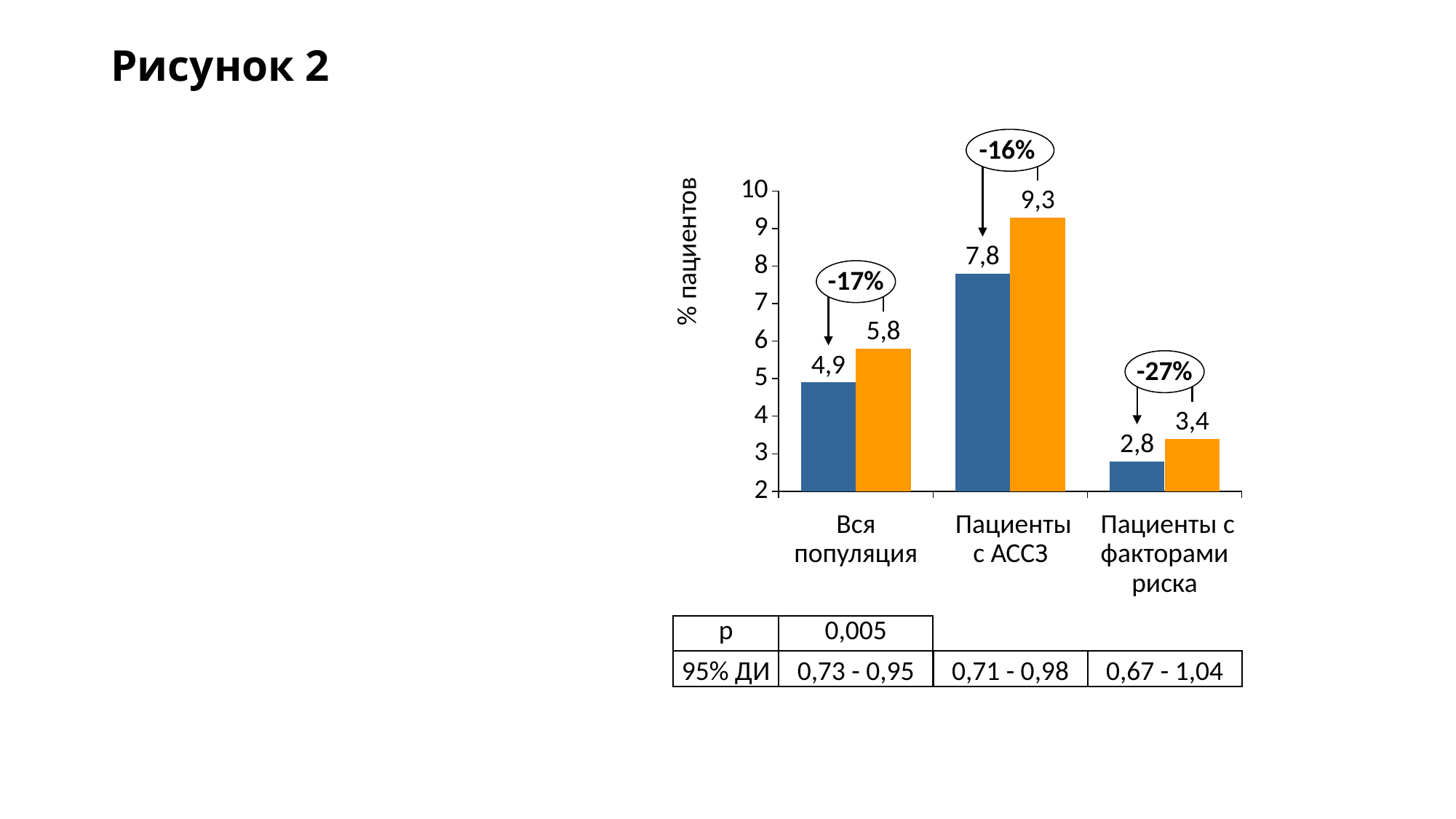
What is the value of the blue bar for Вся популяция? 4,9 What is the difference between the orange and blue bars for Пациенты с АССЗ? 1,5 What is the value of the blue bar for Пациенты с факторами риска? 2,8 What is the label of the vertical axis? % пациентов What is the difference between the orange and blue bars for Вся популяция? 0,9 What kind of chart is shown on the slide? bar chart Which category has the highest orange bar? Пациенты с АССЗ How many categories are shown on the x axis? 3 What is the value of the orange bar for Пациенты с факторами риска? 3,4 Which is larger for Пациенты с АССЗ, the blue bar or the orange bar? the orange bar Which category has the lowest blue bar? Пациенты с факторами риска What is the value of the orange bar for Пациенты с АССЗ? 9,3